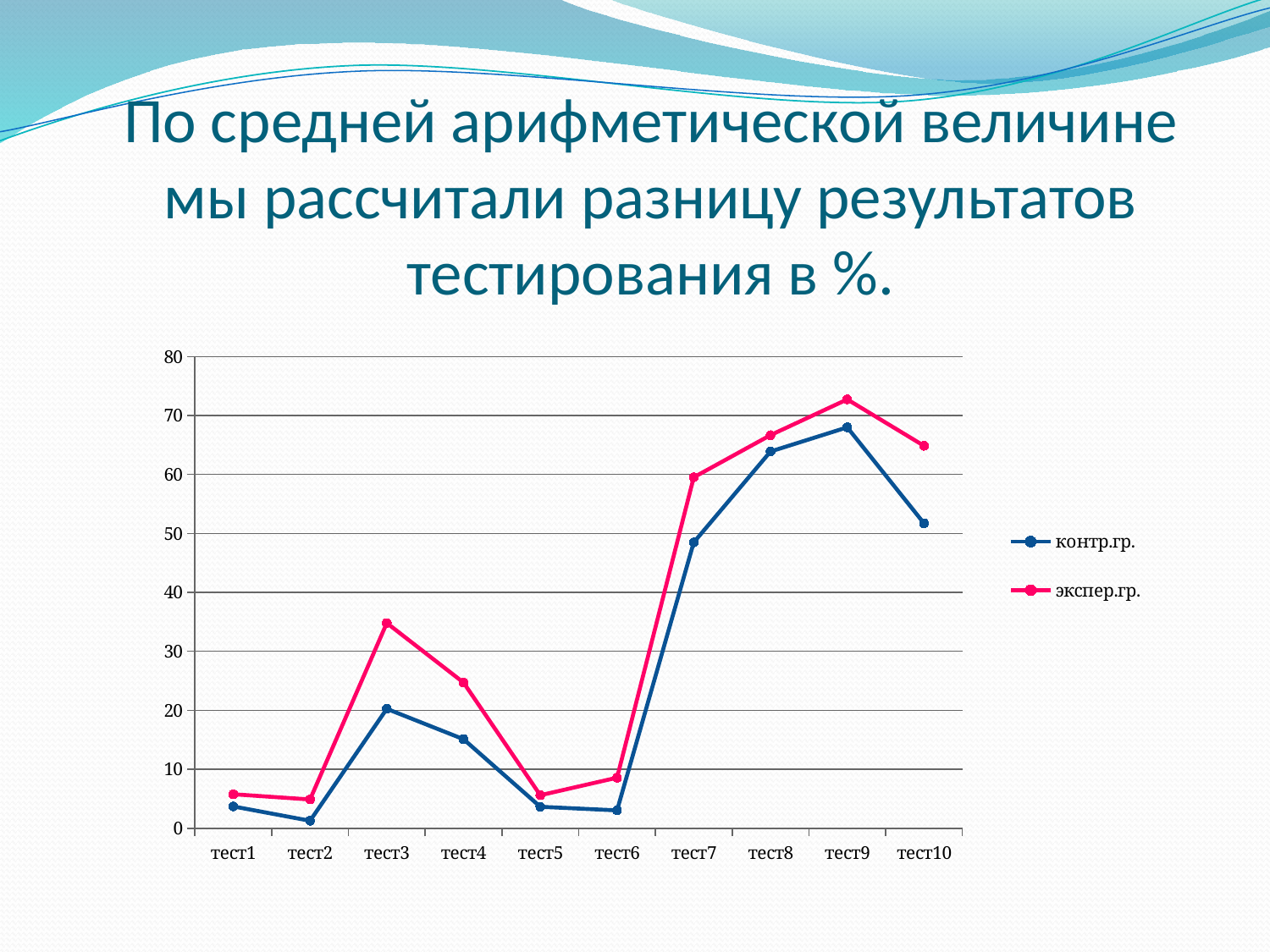
Which series is drawn in pink? экспер.гр. At тест3, which series has the larger value, контр.гр. or экспер.гр.? экспер.гр. Does the экспер.гр. line rise or fall from тест6 to тест9? rise How many test categories are shown on the x axis? 10 Is the value for экспер.гр. at тест9 greater or less than 70? greater How many series does the legend list? 2 Is the value for контр.гр. at тест4 greater or less than 20? less Which test has the highest value for экспер.гр.? тест9 Which test has the highest value for контр.гр.? тест9 At тест10, which series has the larger value, контр.гр. or экспер.гр.? экспер.гр. What kind of chart is shown on the slide? line chart Is the value for экспер.гр. at тест3 greater or less than 30? greater